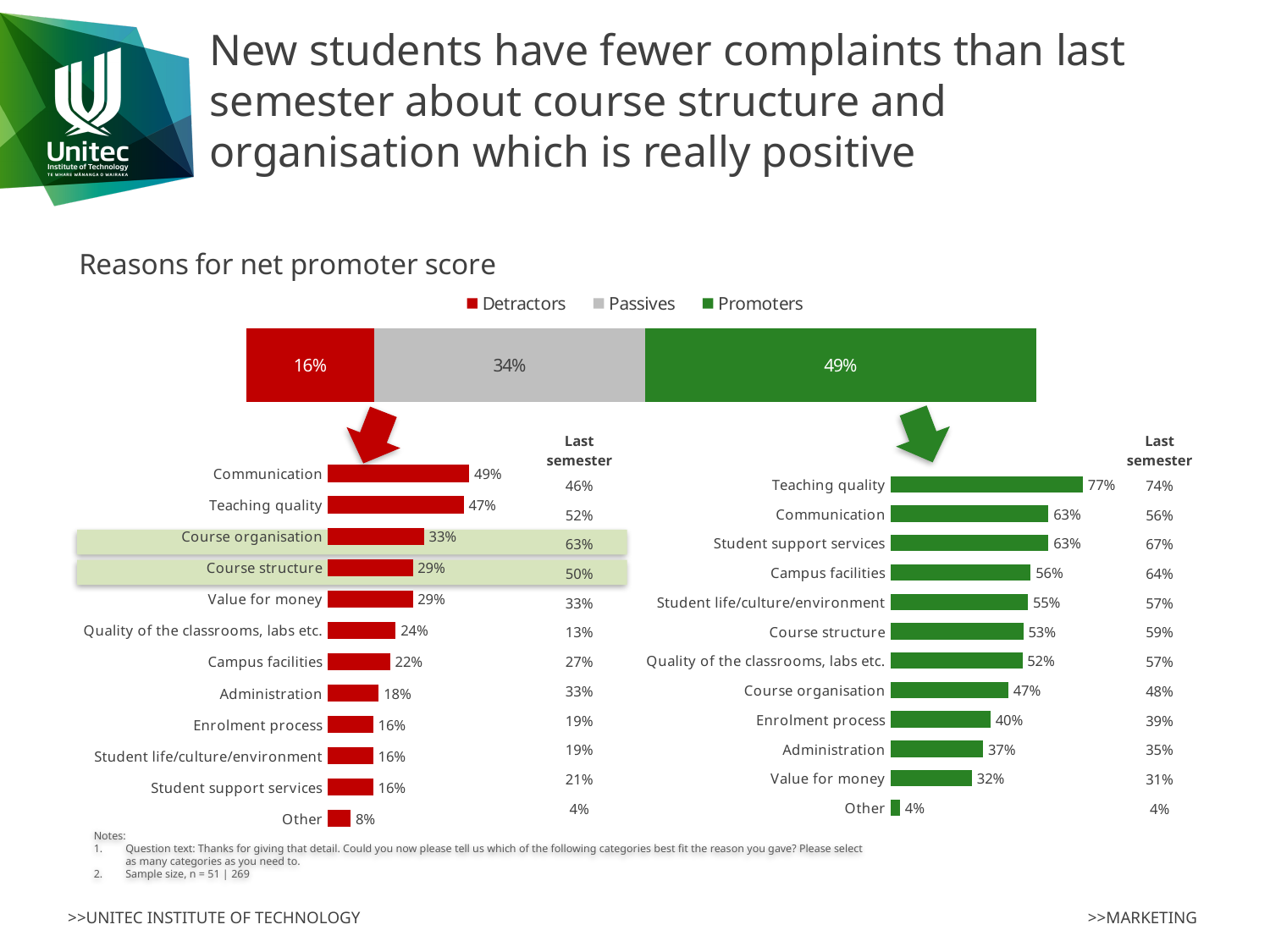
In the green bar chart on the right (Promoters), what is the value for Teaching quality? 77% In the red bar chart on the left (Detractors), what is the difference between Communication and Teaching quality? 2% What type of chart is the green chart on the right (Promoters)? Bar chart In the red bar chart on the left (Detractors), what is the value for Course organisation? 33% In the green bar chart on the right (Promoters), what is the difference between Teaching quality and Value for money? 45% How many categories are shown in the red bar chart on the left (Detractors)? 12 In the top stacked bar chart, what percentage are Passives? 34% In the red bar chart on the left (Detractors), which category has the highest value? Communication How many series does the legend of the top stacked bar chart list? 3 In the red bar chart on the left (Detractors), which category has the lowest value? Other In the top stacked bar chart, what percentage are Promoters? 49% In the green bar chart on the right (Promoters), which is larger, Campus facilities or Course organisation? Campus facilities